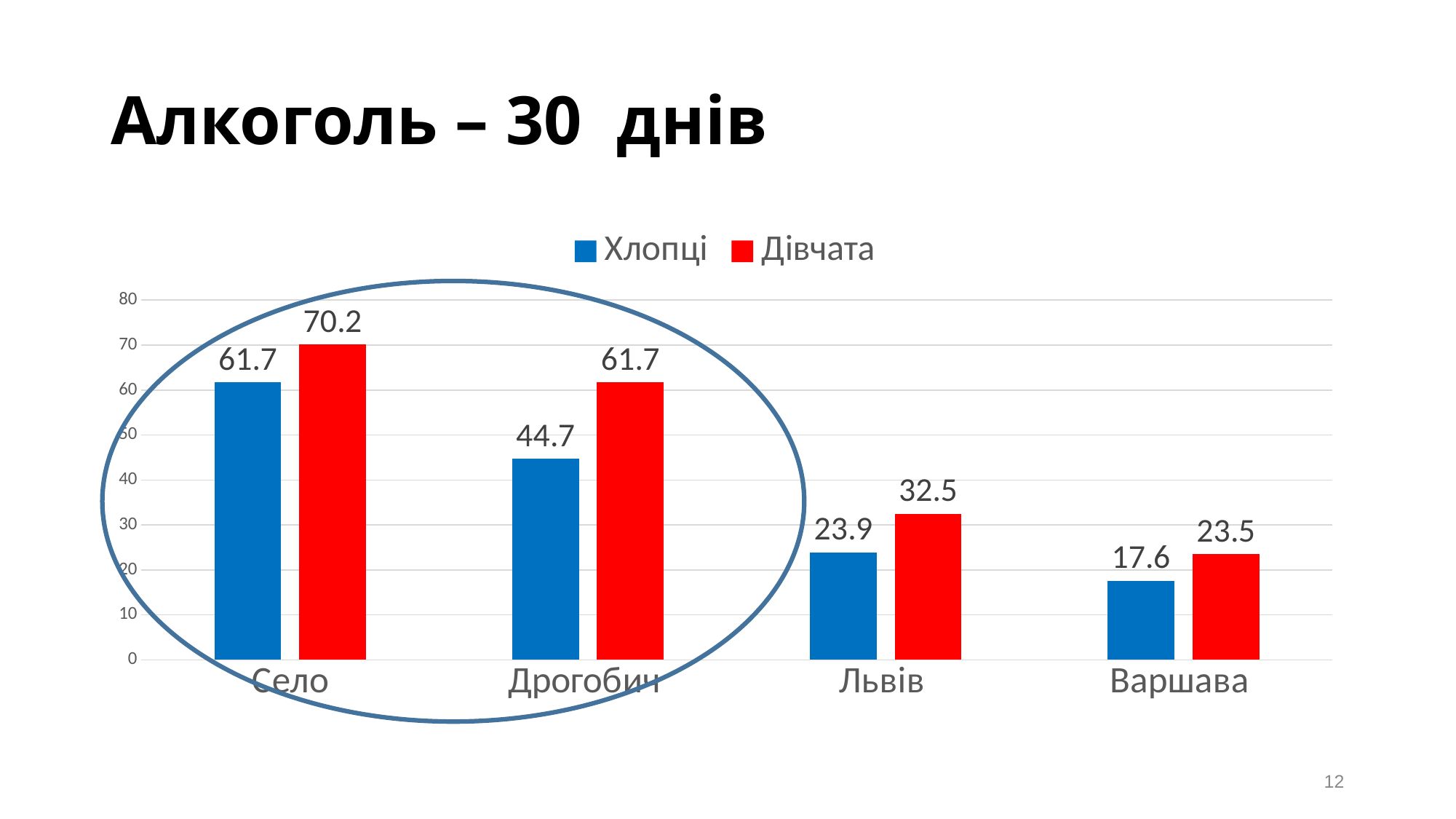
Which category has the lowest value for Хлопці? Варшава Do the values for Хлопці rise or fall from Село to Варшава? Fall What is the value for Хлопці in Варшава? 17.6 What kind of chart is shown on the slide? Bar chart What is the difference between the Дівчата and Хлопці values in Дрогобич? 17 Which is larger in Львів, the value for Хлопці or for Дівчата? Дівчата What is the value for Дівчата in Львів? 32.5 Which category has the highest value for Дівчата? Село What is the value for Дівчата in Дрогобич? 61.7 What is the value for Хлопці in Село? 61.7 How many series does the legend list? 2 How many categories are shown on the x axis? 4